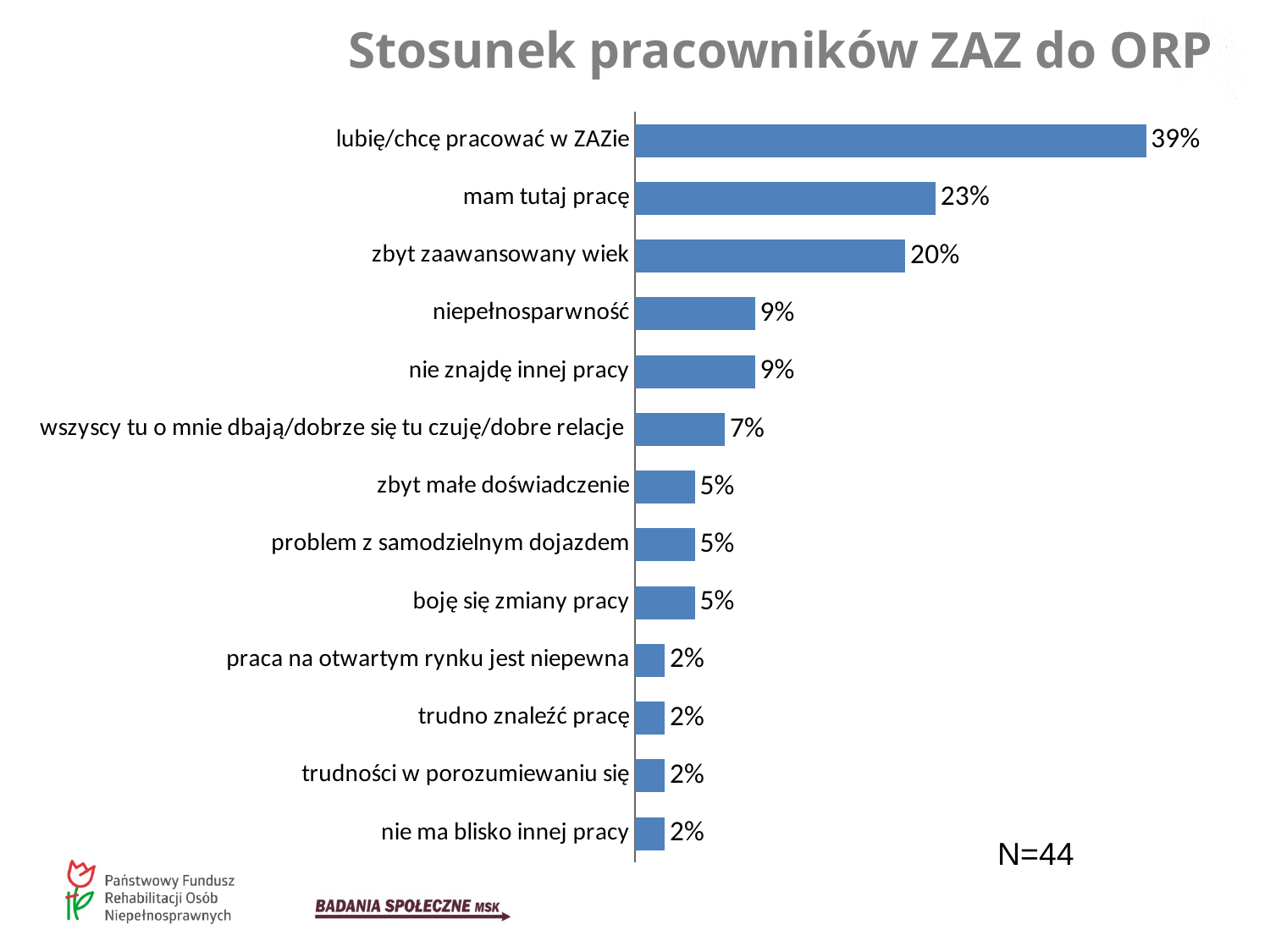
Which category has the highest value? lubię/chcę pracować w ZAZie What is the title of the chart? Stosunek pracowników ZAZ do ORP What is the value for "lubię/chcę pracować w ZAZie"? 39% What is the value for "zbyt zaawansowany wiek"? 20% What kind of chart is shown on the slide? bar chart Which is larger, "niepełnosparwność" or "zbyt małe doświadczenie"? niepełnosparwność What is the value for "boję się zmiany pracy"? 5% How many categories are shown in the chart? 13 What is the value for "wszyscy tu o mnie dbają/dobrze się tu czuję/dobre relacje"? 7% What is the difference between "lubię/chcę pracować w ZAZie" and "mam tutaj pracę"? 16% How many categories have a value of 2%? 4 What is the difference between "mam tutaj pracę" and "zbyt zaawansowany wiek"? 3%